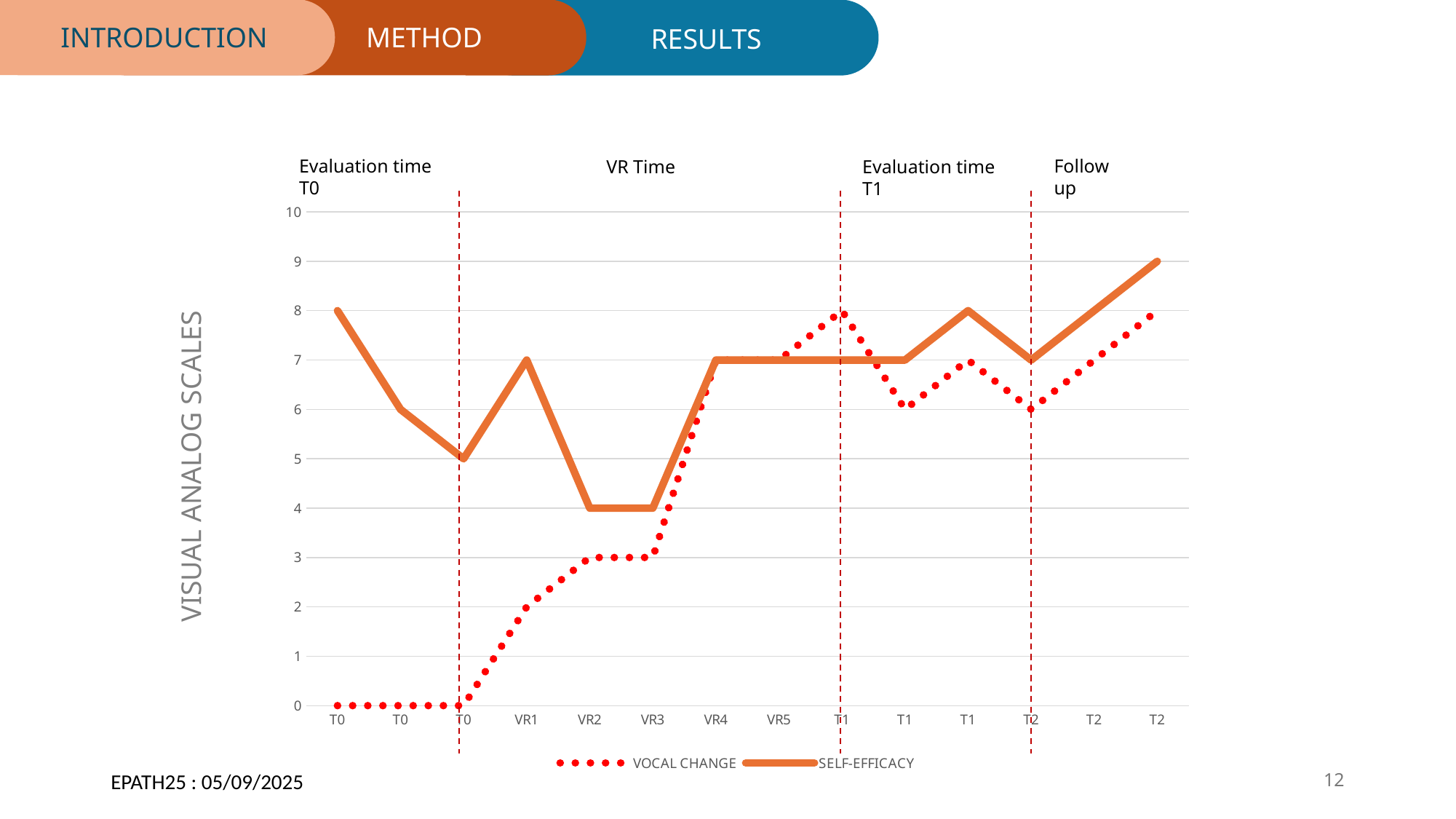
What is the SELF-EFFICACY value at the last T2 point? 9 What is the SELF-EFFICACY value at the first T0 point? 8 What is the VOCAL CHANGE value at the first T0 point? 0 At which x-axis point does SELF-EFFICACY reach its highest value? the last T2 What is the SELF-EFFICACY value at VR2? 4 Is the VOCAL CHANGE value at VR1 greater or less than 3? less What are the two series named in the legend? VOCAL CHANGE and SELF-EFFICACY What is the difference between the SELF-EFFICACY value at the first T0 point and at the third T0 point? 3 How many series does the legend list? 2 How many points are plotted along the x axis for each series? 14 What is the label on the vertical axis? VISUAL ANALOG SCALES What kind of chart is shown on the slide? line chart